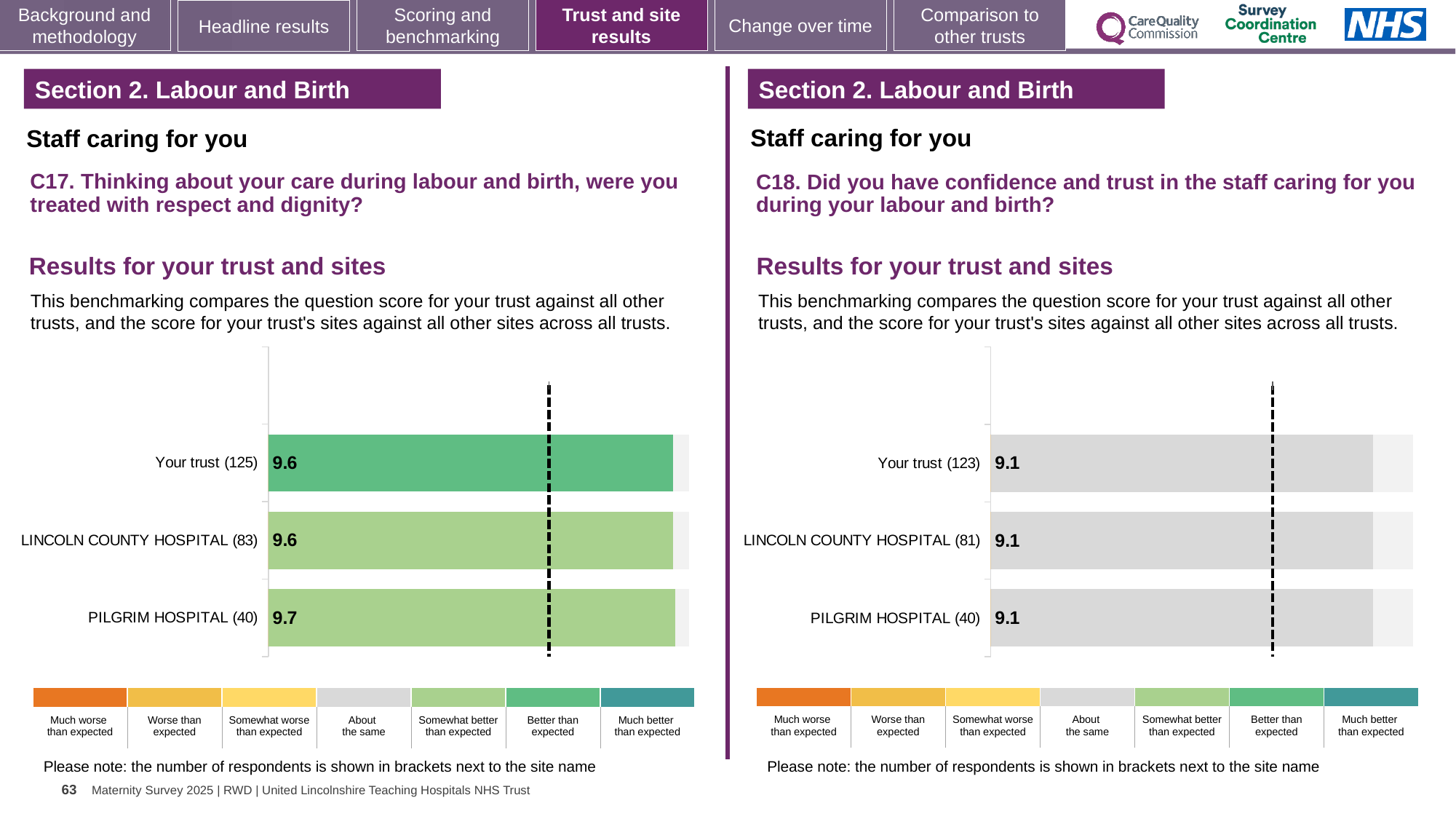
In the C17 chart on the left, what is the difference between the scores for PILGRIM HOSPITAL and Your trust? 0.1 In the C17 chart on the left, what is the score for Your trust? 9.6 In the C17 chart on the left, what is the score for LINCOLN COUNTY HOSPITAL? 9.6 In the C18 chart on the right, what is the score for LINCOLN COUNTY HOSPITAL? 9.1 In the C18 chart on the right, how many bars are plotted? 3 Which is larger: the score for Your trust in the C17 chart on the left or the score for Your trust in the C18 chart on the right? C17 (9.6) In the C18 chart on the right, what is the score for Your trust? 9.1 In the C17 chart on the left, what is the score for PILGRIM HOSPITAL? 9.7 What kind of chart is used in the C17 chart on the left? Bar chart In the C17 chart on the left, which site has the highest score? PILGRIM HOSPITAL In the C18 chart on the right, what is the score for PILGRIM HOSPITAL? 9.1 In the C17 chart on the left, how many respondents are shown in brackets for LINCOLN COUNTY HOSPITAL? 83